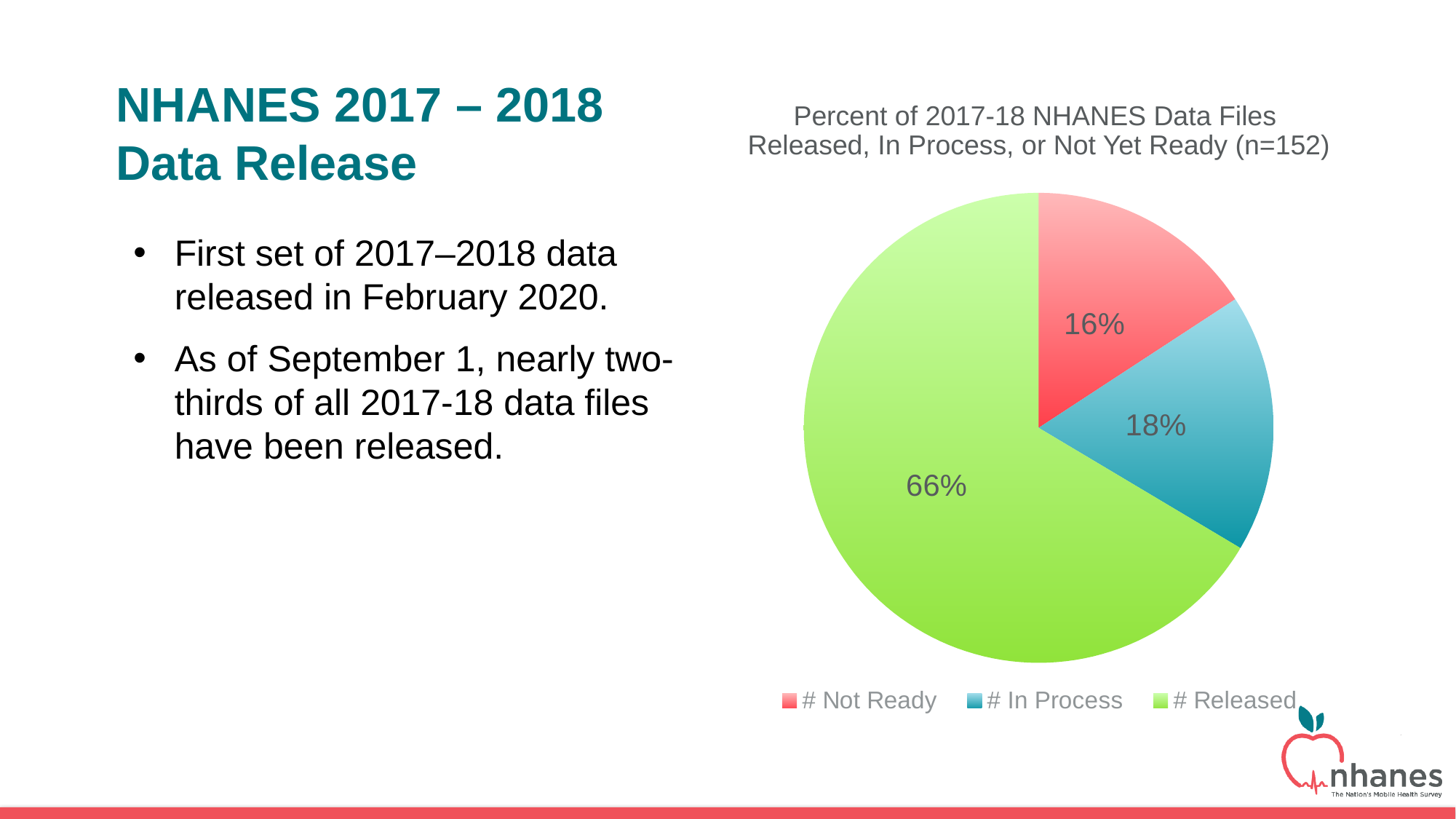
What is the title of the pie chart? Percent of 2017-18 NHANES Data Files Released, In Process, or Not Yet Ready (n=152) Which category has the smallest share of the pie? # Not Ready How many slices does the pie chart have? 3 How many entries does the legend list? 3 What type of chart is shown on the slide? pie chart Which category has the largest share of the pie? # Released What percentage of the 2017-18 NHANES data files are shown as # Not Ready? 16% What percentage of the 2017-18 NHANES data files are shown as # In Process? 18% What is the difference in percentage points between # Released and # In Process? 48 What percentage of the 2017-18 NHANES data files are shown as # Released? 66% Which is larger, the share for # In Process or the share for # Not Ready? # In Process What is the difference in percentage points between # In Process and # Not Ready? 2